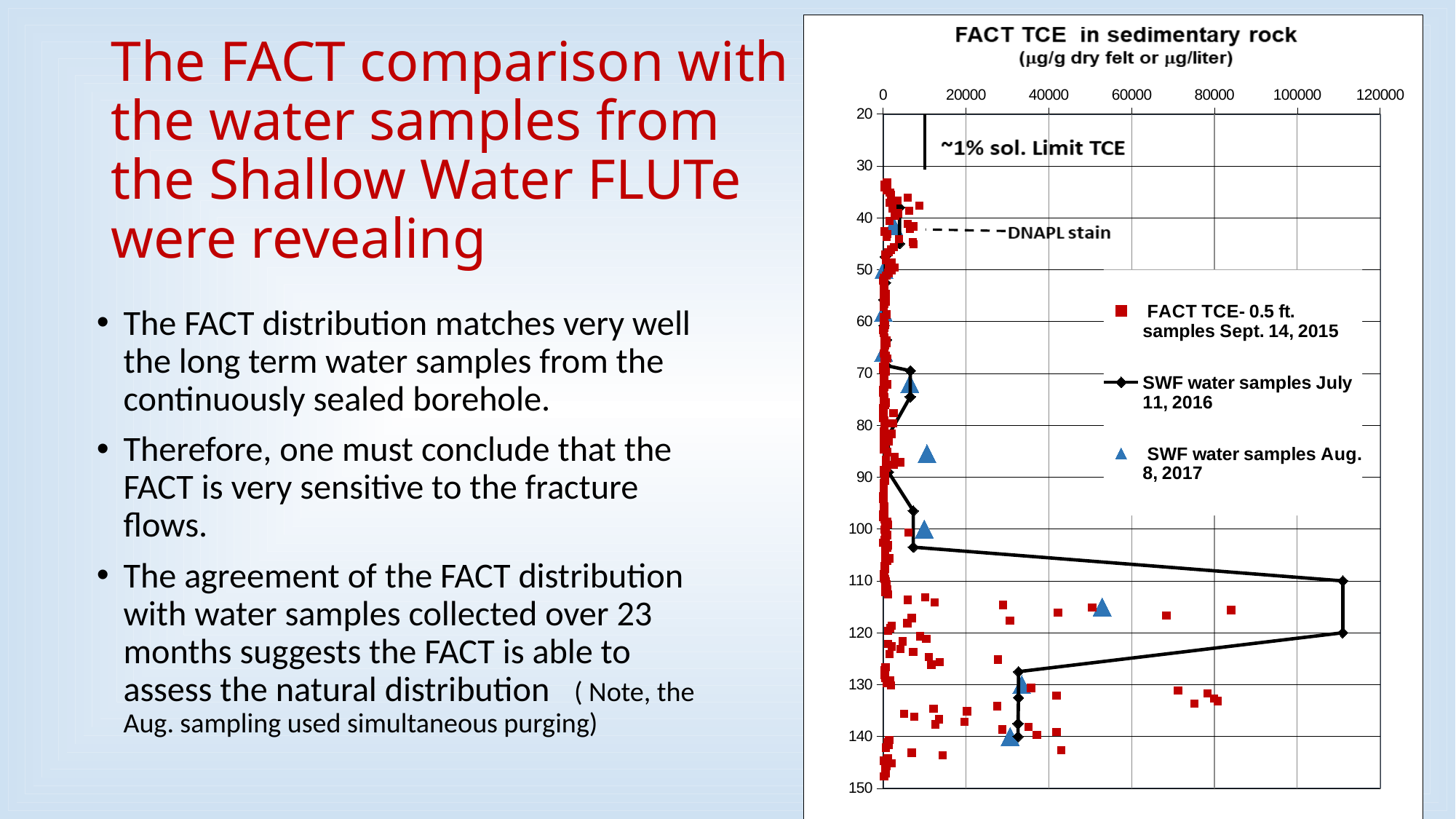
Is the value of the SWF water samples Aug. 8, 2017 series at depth 115 greater or less than 40000? greater What is the title of the chart? FACT TCE in sedimentary rock What kind of chart is shown on the slide? scatter chart What is the maximum value shown on the horizontal axis of the chart? 120000 Is the value of the SWF water samples July 11, 2016 series at depth 110 greater or less than 100000? greater Which series in the legend is plotted with red square markers? FACT TCE- 0.5 ft. samples Sept. 14, 2015 Is the value of the SWF water samples Aug. 8, 2017 series at depth 130 greater or less than 40000? less How many series does the chart legend list? 3 At which depth does the SWF water samples July 11, 2016 series reach its highest value, 110 or 70? 110